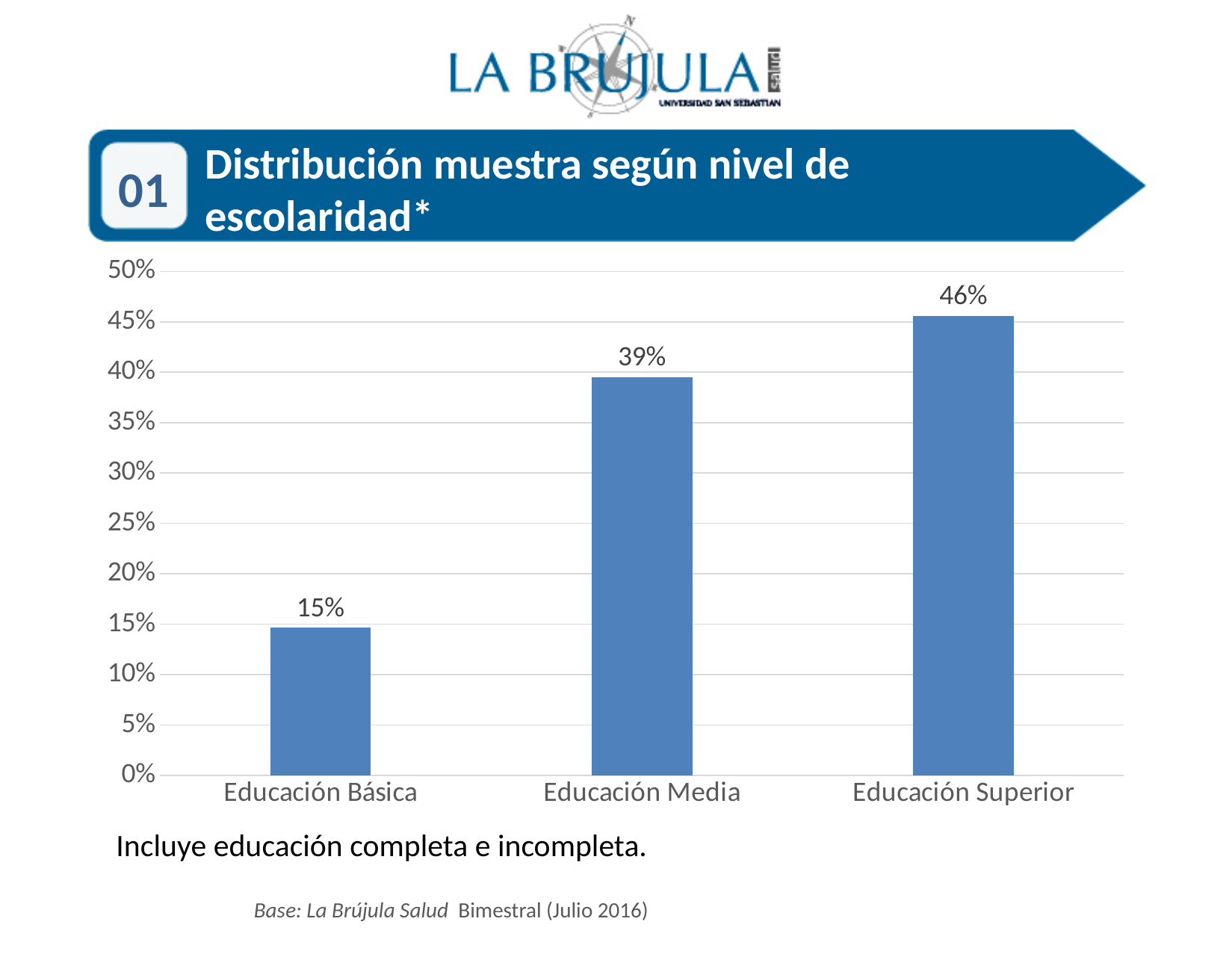
Which category has the highest value? Educación Superior Do the values rise or fall from Educación Básica to Educación Superior? Rise What is the difference between the values for Educación Media and Educación Básica? 24% What is the value for Educación Superior? 46% What kind of chart is shown on the slide? Bar chart Which category has the lowest value? Educación Básica Is the value for Educación Superior greater or less than 40%? greater Which is larger, the value for Educación Media or the value for Educación Básica? Educación Media What is the value for Educación Media? 39% What is the difference between the values for Educación Superior and Educación Media? 7% How many categories are shown on the x axis? 3 What is the value for Educación Básica? 15%